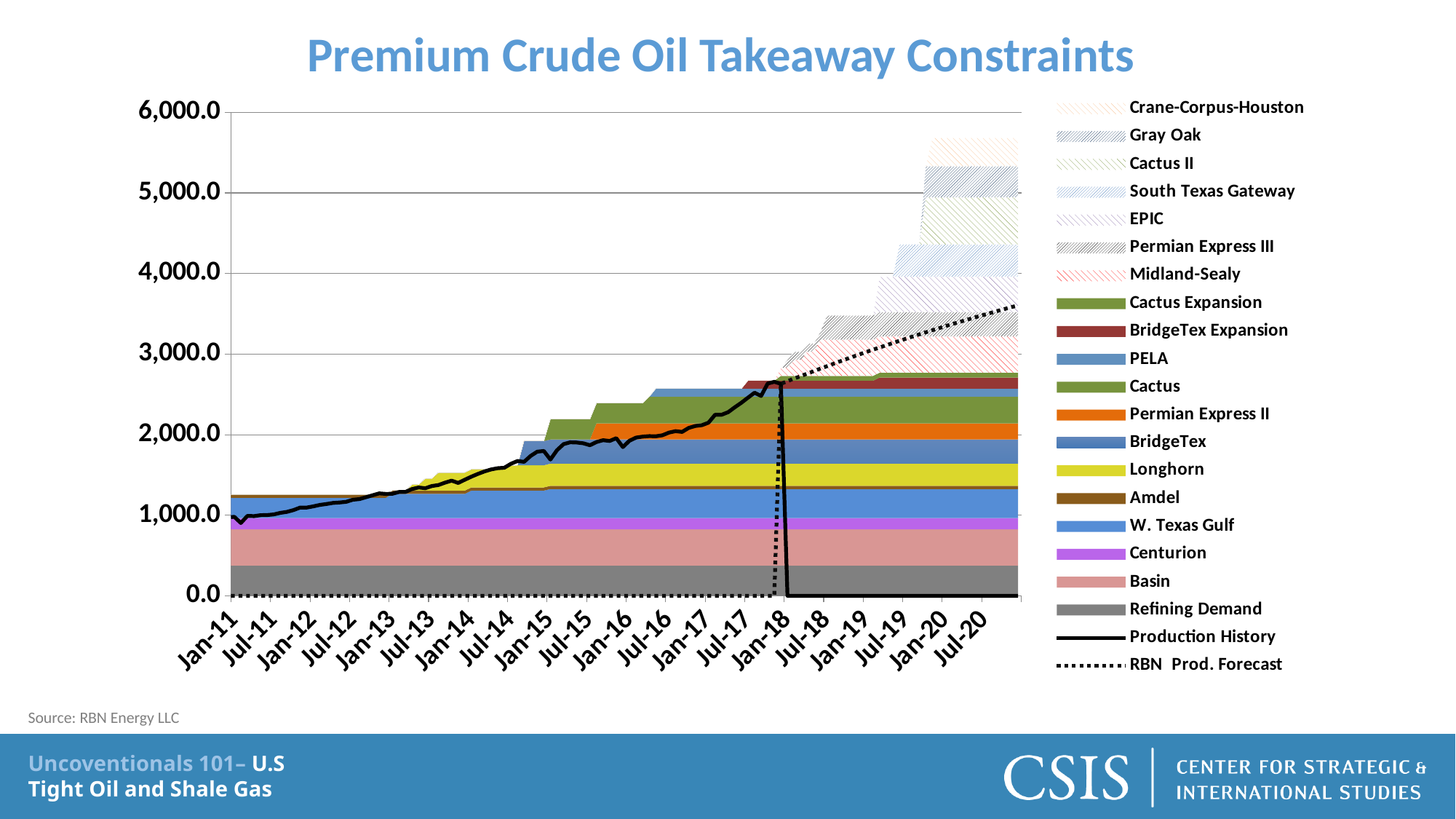
Which series forms the bottom layer of the stacked areas? Refining Demand What is the title of the chart? Premium Crude Oil Takeaway Constraints Is the value of the RBN Prod. Forecast line at Jul-20 greater or less than 3,000.0? greater How many date labels are shown along the x axis? 20 How many entries does the chart's legend list? 21 Does the Production History line rise or fall from Jan-11 to Jan-18? Rises Is the top of the Refining Demand area greater or less than 1,000.0? less What is the highest value labelled on the y axis? 6,000.0 What kind of chart is shown on the slide? Stacked area chart Is the top of the stacked areas at Jan-11 greater or less than 2,000.0? less